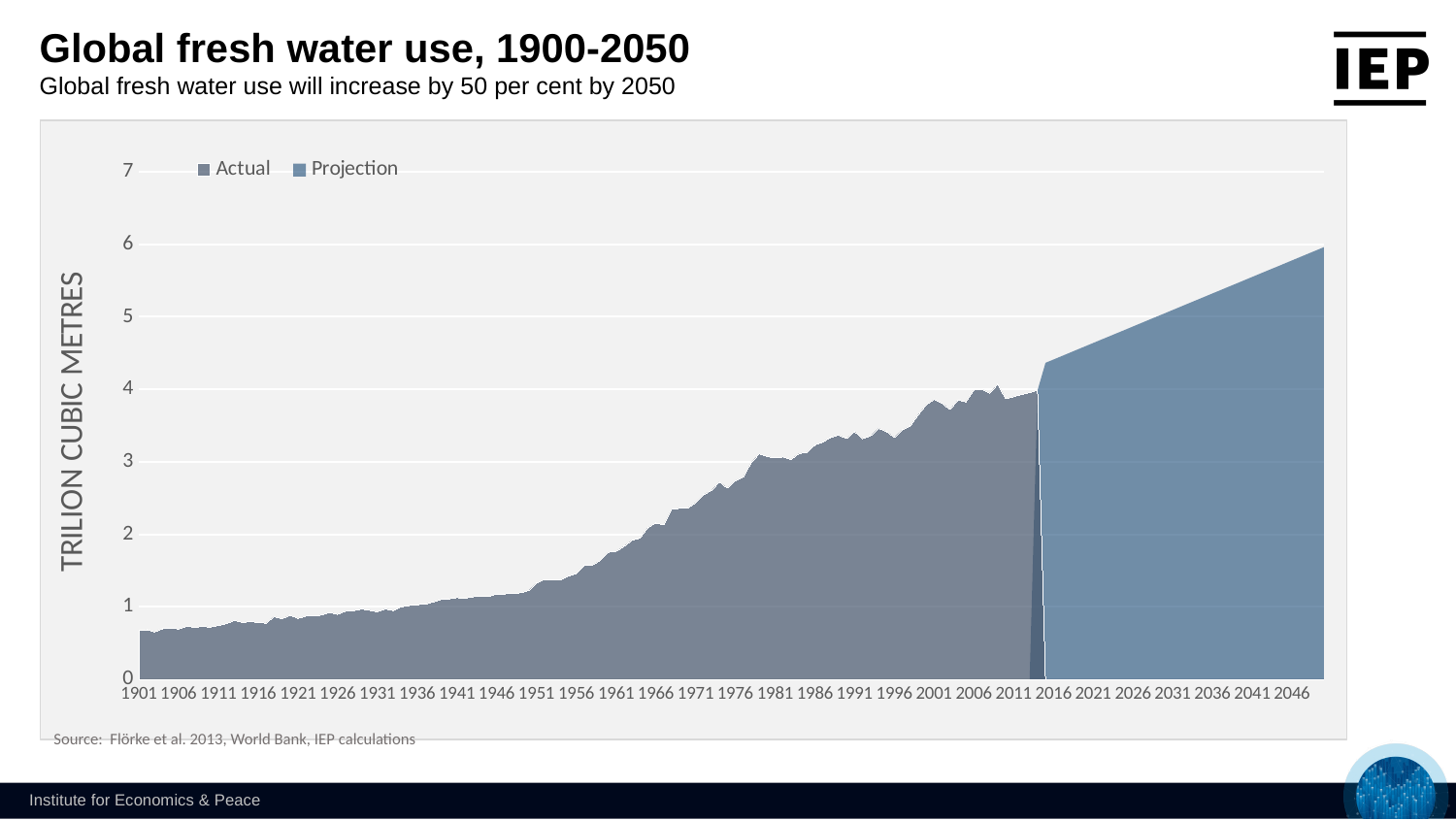
Is the value for 1901 greater or less than 1? less Do the values generally rise or fall from 1901 to 2046? Rise Is the value for 2021 greater or less than 5? less Is the value for 2046 greater or less than 5? greater How many series does the legend list? 2 Which is larger, the value for 1901 or the value for 2046? 2046 What kind of chart is shown on the slide? Area chart What is the label on the vertical axis? TRILION CUBIC METRES What are the two series named in the legend? Actual and Projection